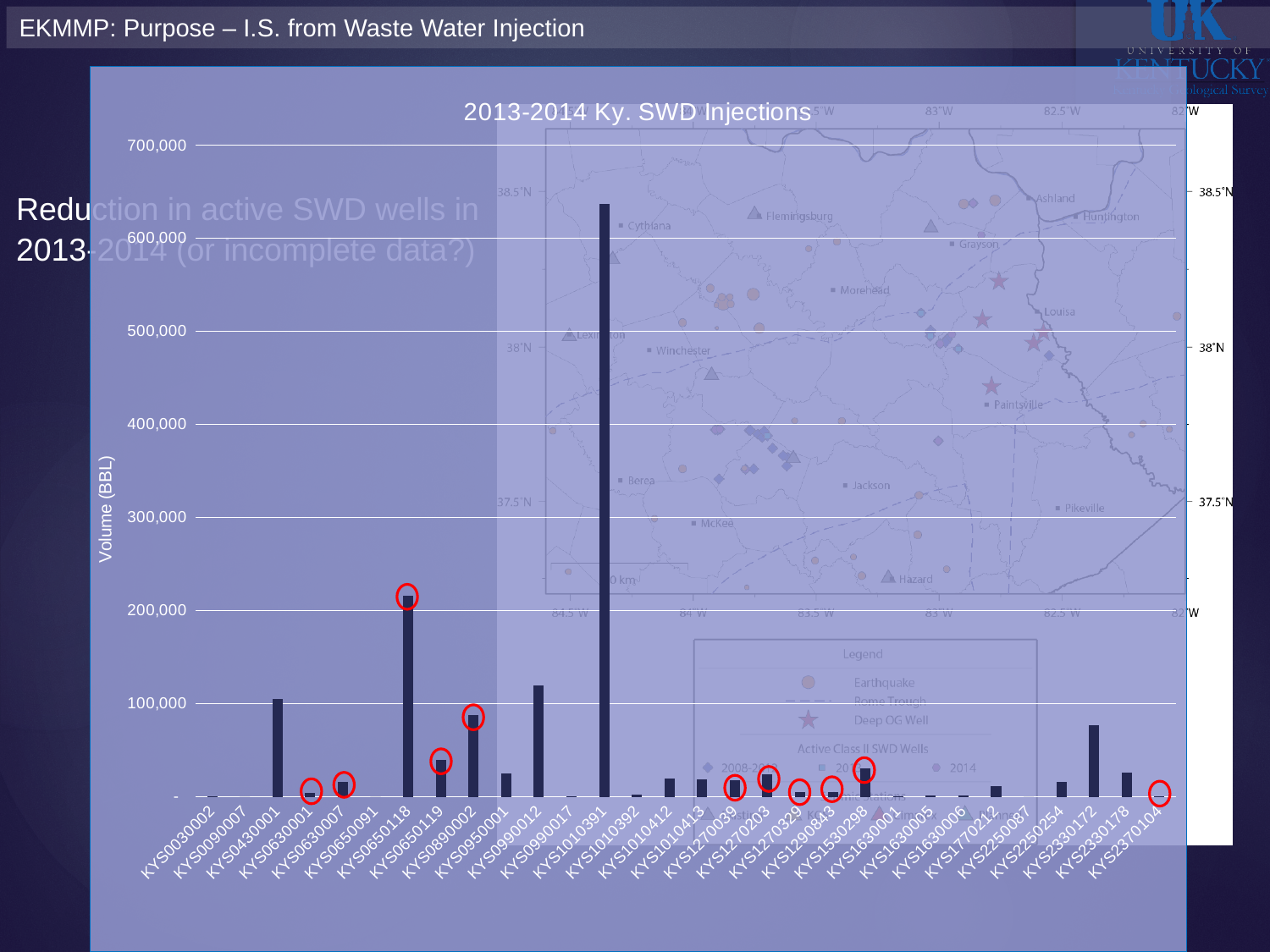
What type of chart is shown on the slide? bar chart Is the value for KYS2330172 greater or less than 100,000? less Is the value for KYS0990012 greater or less than 100,000? greater Is the value for KYS1010391 greater or less than 600,000? greater How many wells are listed along the x axis of the chart? 30 What is the label on the vertical axis of the chart? Volume (BBL) Which well has the highest injection volume in the chart? KYS1010391 Which has a larger injection volume, KYS1010391 or KYS0650118? KYS1010391 Which has a larger injection volume, KYS0650118 or KYS0990012? KYS0650118 What is the title of the chart? 2013-2014 Ky. SWD Injections